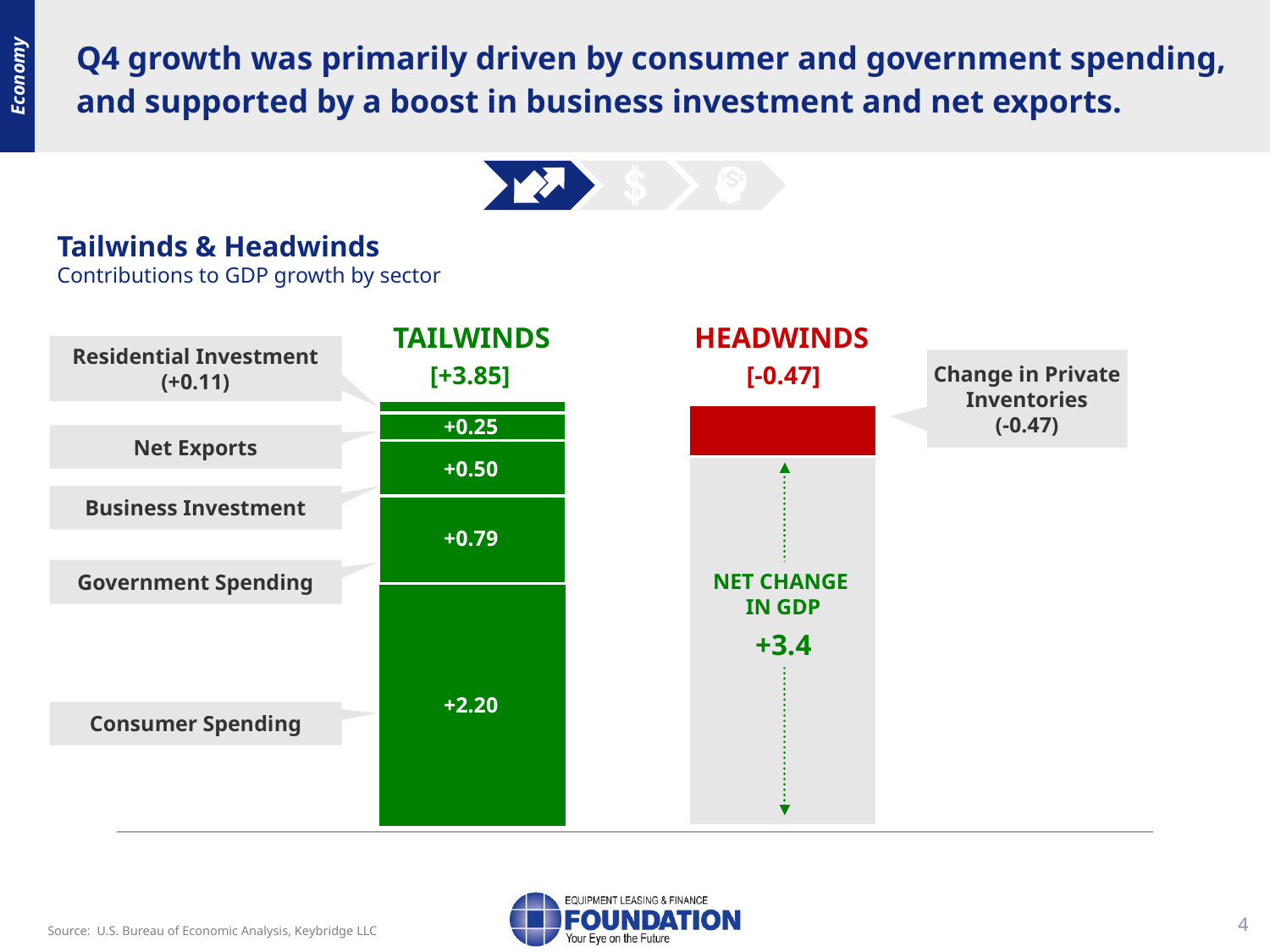
Which sector contributes the least to the Tailwinds bar? Residential Investment Which sector contributes the most to the Tailwinds bar? Consumer Spending What is the difference between the Consumer Spending and Government Spending contributions? 1.41 What is the total of the Tailwinds stacked bar? +3.85 What is the net change in GDP shown on the chart? +3.4 Which is larger, the Business Investment contribution or the Net Exports contribution? Business Investment What is the contribution of Consumer Spending to GDP growth shown in the Tailwinds bar? +2.20 What is the contribution of Net Exports shown in the Tailwinds bar? +0.25 What is the contribution of Business Investment shown in the Tailwinds bar? +0.50 What is the contribution of Residential Investment shown on the slide? +0.11 What is the value of the Change in Private Inventories headwind? -0.47 What is the contribution of Government Spending shown in the Tailwinds bar? +0.79